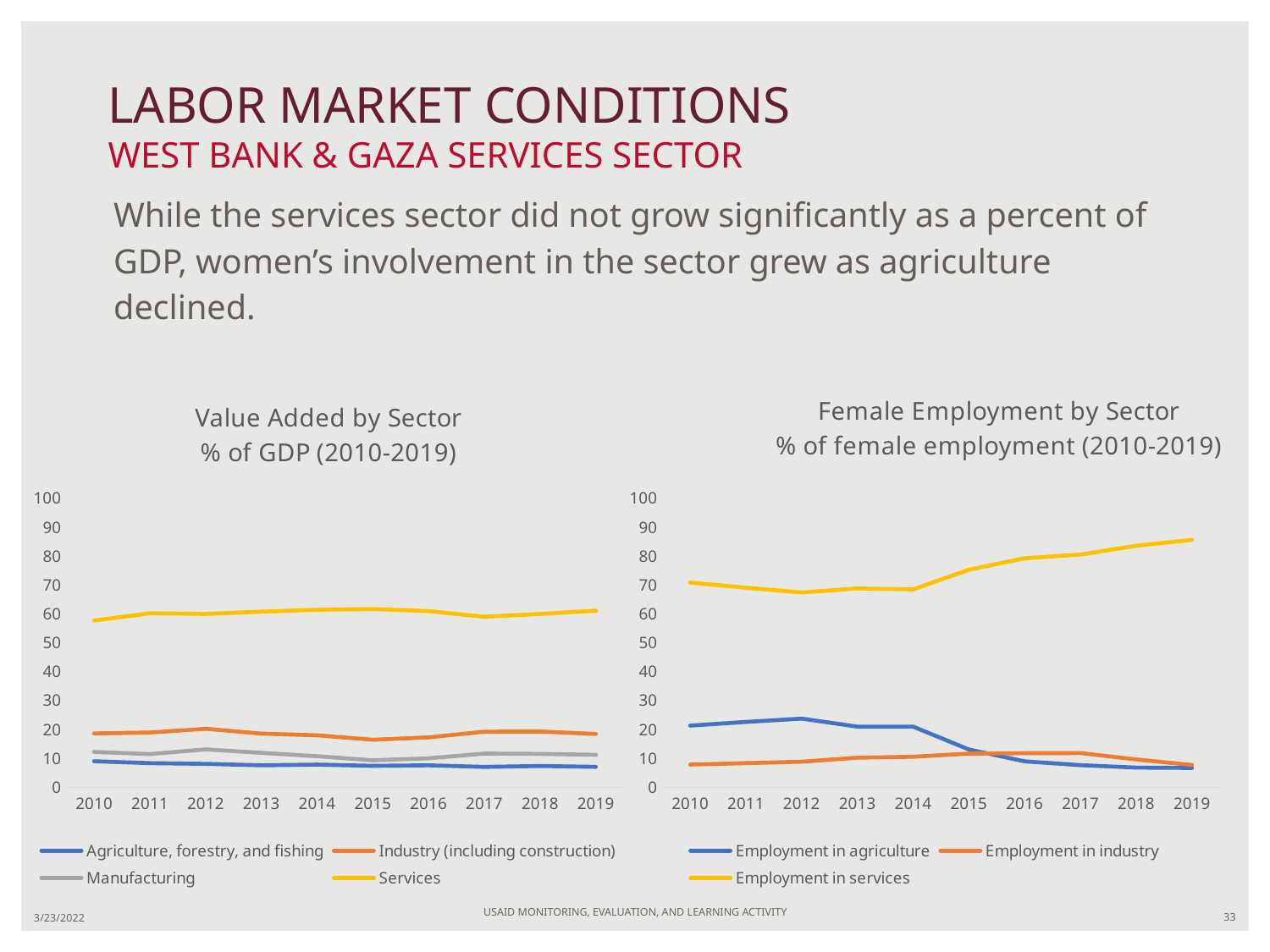
In the 'Value Added by Sector' chart, is the value for Services in 2010 greater or less than 50? greater In the 'Female Employment by Sector' chart, is the value for 'Employment in agriculture' in 2019 greater or less than 10? less In the 'Female Employment by Sector' chart, does the 'Employment in agriculture' line rise or fall from 2010 to 2019? fall In the 'Female Employment by Sector' chart, does the 'Employment in services' line rise or fall from 2010 to 2019? rise How many years are shown on the x axis of the 'Female Employment by Sector' chart? 10 How many series does the legend of the 'Value Added by Sector' chart list? 4 In the 'Value Added by Sector' chart, which is larger in 2015: Services or Industry (including construction)? Services In the 'Female Employment by Sector' chart, is the value for 'Employment in services' in 2019 greater or less than 80? greater What kind of chart is the 'Value Added by Sector' chart on the left? line chart In the 'Value Added by Sector' chart, which series has the highest value in 2019? Services How many series does the legend of the 'Female Employment by Sector' chart list? 3 In the 'Female Employment by Sector' chart, which series has the lowest value in 2010? Employment in industry